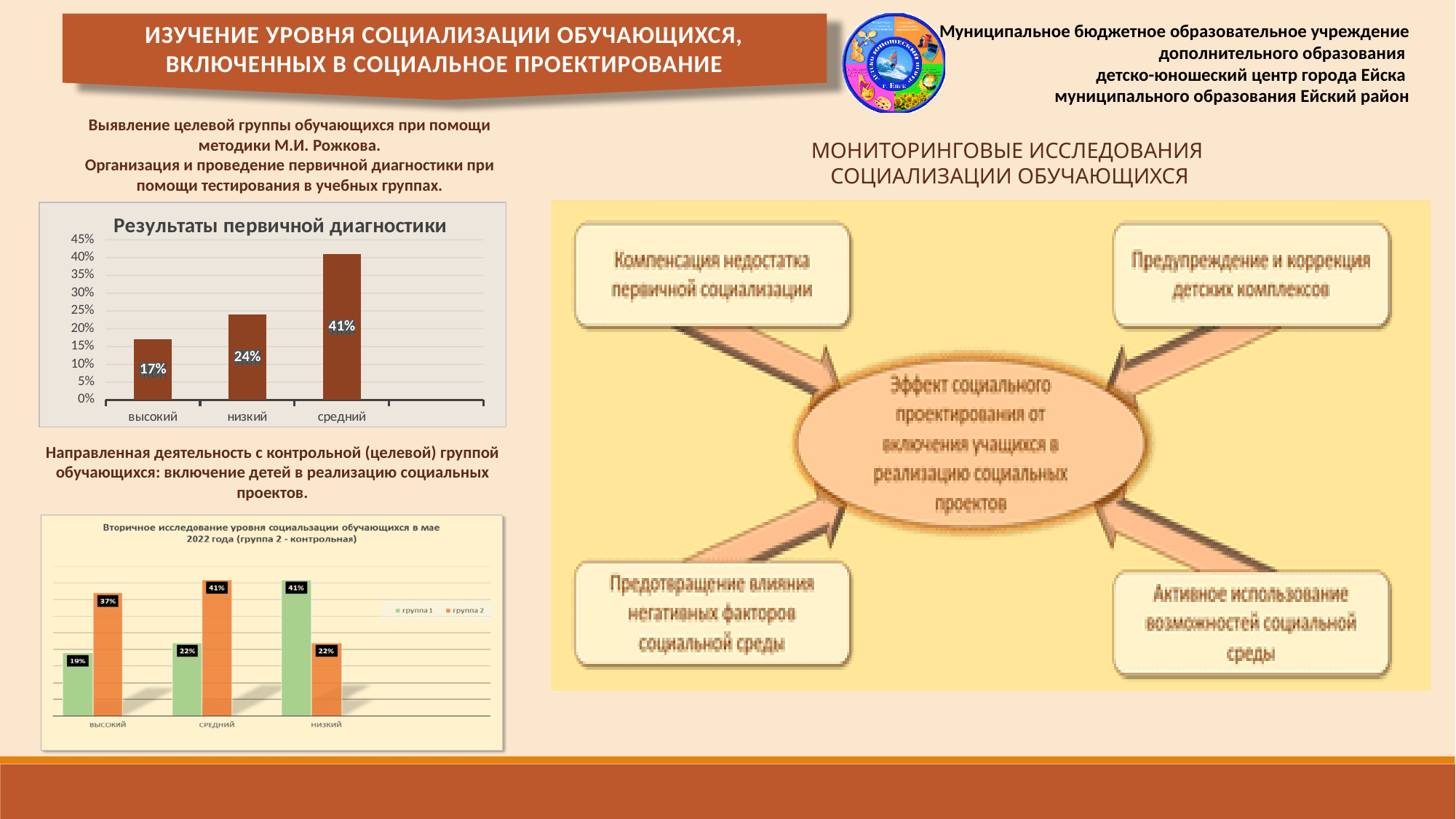
In the chart 'Вторичное исследование уровня социализации обучающихся в мае 2022 года', what is the value of 'группа 2' for 'высокий'? 37% In the chart 'Результаты первичной диагностики', what is the value for 'высокий'? 17% How many series does the legend of the chart 'Вторичное исследование уровня социализации обучающихся в мае 2022 года' list? 2 In the chart 'Результаты первичной диагностики', which category has the lowest value? высокий In the chart 'Вторичное исследование уровня социализации обучающихся в мае 2022 года', what is the value of 'группа 1' for 'низкий'? 41% What type of chart is 'Результаты первичной диагностики'? bar chart In the chart 'Результаты первичной диагностики', how many categories are shown on the x axis? 3 In the chart 'Вторичное исследование уровня социализации обучающихся в мае 2022 года', which is larger for 'средний': 'группа 1' or 'группа 2'? группа 2 In the chart 'Результаты первичной диагностики', what is the difference between 'средний' and 'низкий'? 17% In the chart 'Результаты первичной диагностики', what is the value for 'средний'? 41% In the chart 'Вторичное исследование уровня социализации обучающихся в мае 2022 года', which category has the highest value for 'группа 1'? низкий In the chart 'Вторичное исследование уровня социализации обучающихся в мае 2022 года', what is the difference between 'группа 2' and 'группа 1' for 'высокий'? 18%